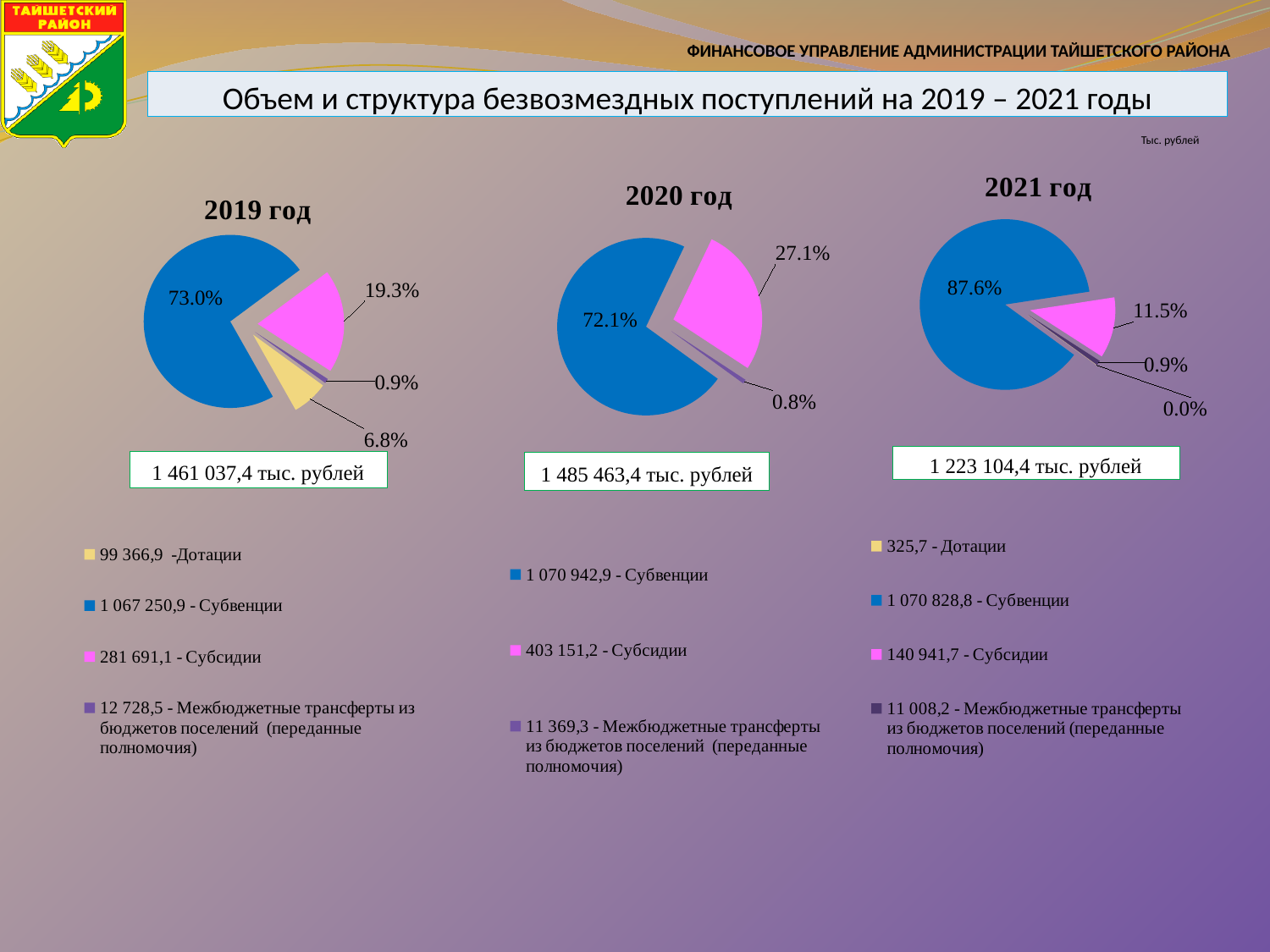
In the "2019 год" chart, which category has the smallest slice? Межбюджетные трансферты из бюджетов поселений (переданные полномочия) What type of chart is used for the "2019 год" chart? pie chart In the "2019 год" chart, what share of the pie does the Субвенции slice have? 73.0% In the "2019 год" chart, what share of the pie does the Дотации slice have? 6.8% In the "2020 год" chart, what value does the legend give for Субвенции? 1 070 942,9 What total amount is shown below the "2021 год" chart? 1 223 104,4 тыс. рублей In the "2020 год" chart, what share of the pie does the Субсидии slice have? 27.1% In the "2019 год" chart, which category has the largest slice? Субвенции How many categories does the legend of the "2020 год" chart list? 3 Which is larger: the Субсидии share in the "2020 год" chart or the Субсидии share in the "2021 год" chart? 2020 год In the "2021 год" chart, what value does the legend give for Дотации? 325,7